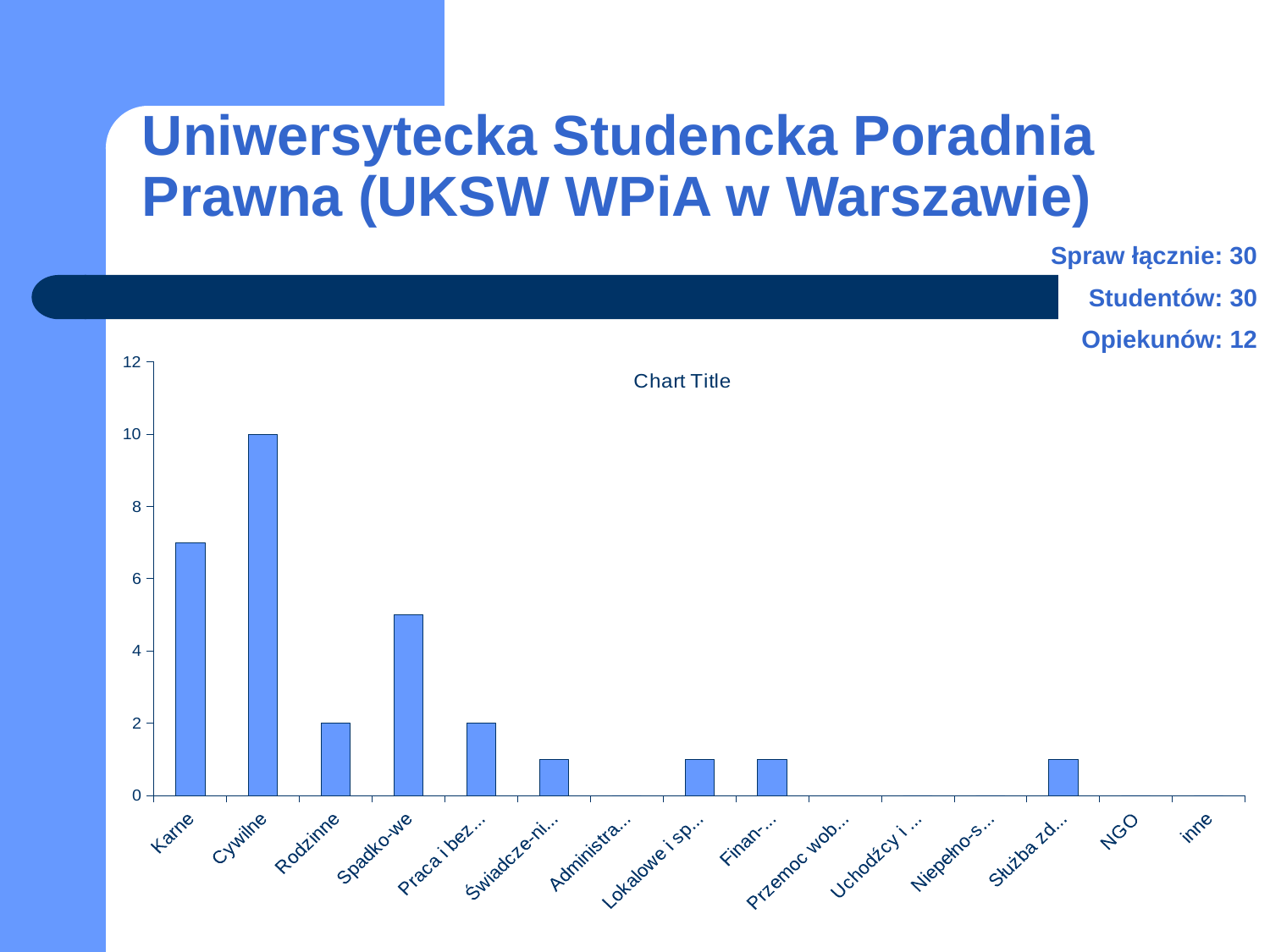
Is the value for Karne greater or less than 8? less How many categories are shown on the x axis? 15 What kind of chart is shown on the slide? bar chart What is the value for Rodzinne? 2 Which is larger, the value for Karne or the value for Spadko-we? Karne Which category has the highest value? Cywilne Is the value for Spadko-we greater or less than 4? greater What is the title of the chart? Chart Title Is the value for Spadko-we greater or less than 6? less What is the value for Cywilne? 10 What is the difference between the values for Cywilne and Rodzinne? 8